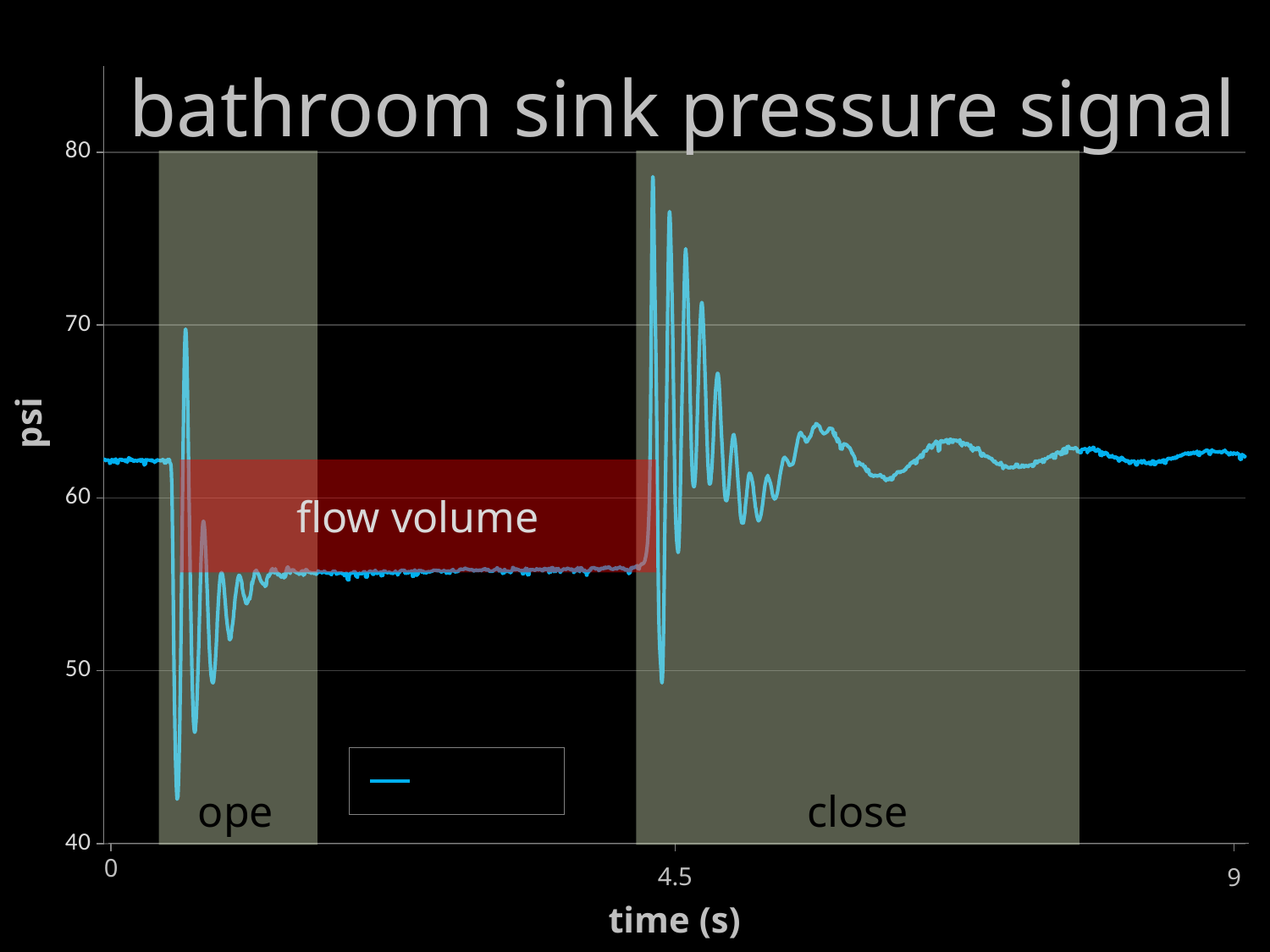
Which shaded region contains the lower pressure dip, 'ope' or 'close'? ope Which shaded region contains the higher pressure peak, 'ope' or 'close'? close Is the pressure at time 0 greater or less than 60 psi? greater What kind of chart is shown on the slide? line chart Is the steady pressure level during the 'flow volume' period greater or less than 60 psi? less Is the highest pressure peak in the 'close' region greater or less than 70 psi? greater What is the title of the chart? bathroom sink pressure signal What is the maximum value shown on the y axis? 80 What is the label of the y axis? psi How many series does the legend list? 1